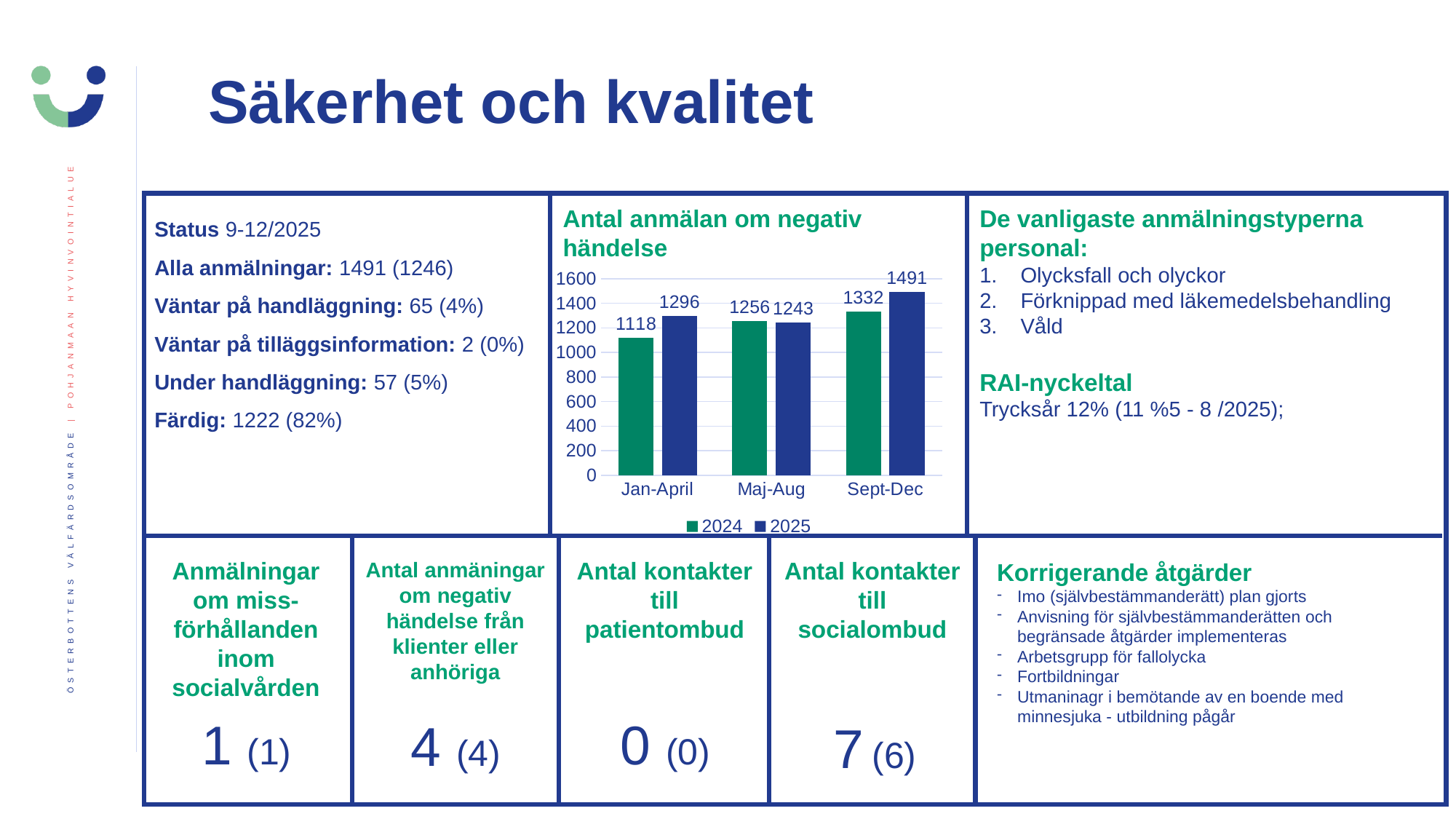
In the chart "Antal anmälan om negativ händelse", is the 2024 value for Jan-April greater or less than 1200? less In the chart "Antal anmälan om negativ händelse", do the 2024 values rise or fall from Jan-April to Sept-Dec? rise In the chart "Antal anmälan om negativ händelse", what is the difference between the 2025 and 2024 values in Sept-Dec? 159 How many series does the legend of the chart "Antal anmälan om negativ händelse" list? 2 In the chart "Antal anmälan om negativ händelse", which period has the lowest value for 2025? Maj-Aug In the chart "Antal anmälan om negativ händelse", which period has the highest value for 2024? Sept-Dec How many periods are shown on the x axis of the chart "Antal anmälan om negativ händelse"? 3 In the chart "Antal anmälan om negativ händelse", what is the value for 2025 in Maj-Aug? 1243 In the chart "Antal anmälan om negativ händelse", which is larger in Jan-April: the 2024 value or the 2025 value? 2025 In the chart "Antal anmälan om negativ händelse", what is the value for 2025 in Sept-Dec? 1491 What type of chart is shown under the title "Antal anmälan om negativ händelse"? bar chart In the chart "Antal anmälan om negativ händelse", what is the value for 2024 in Jan-April? 1118